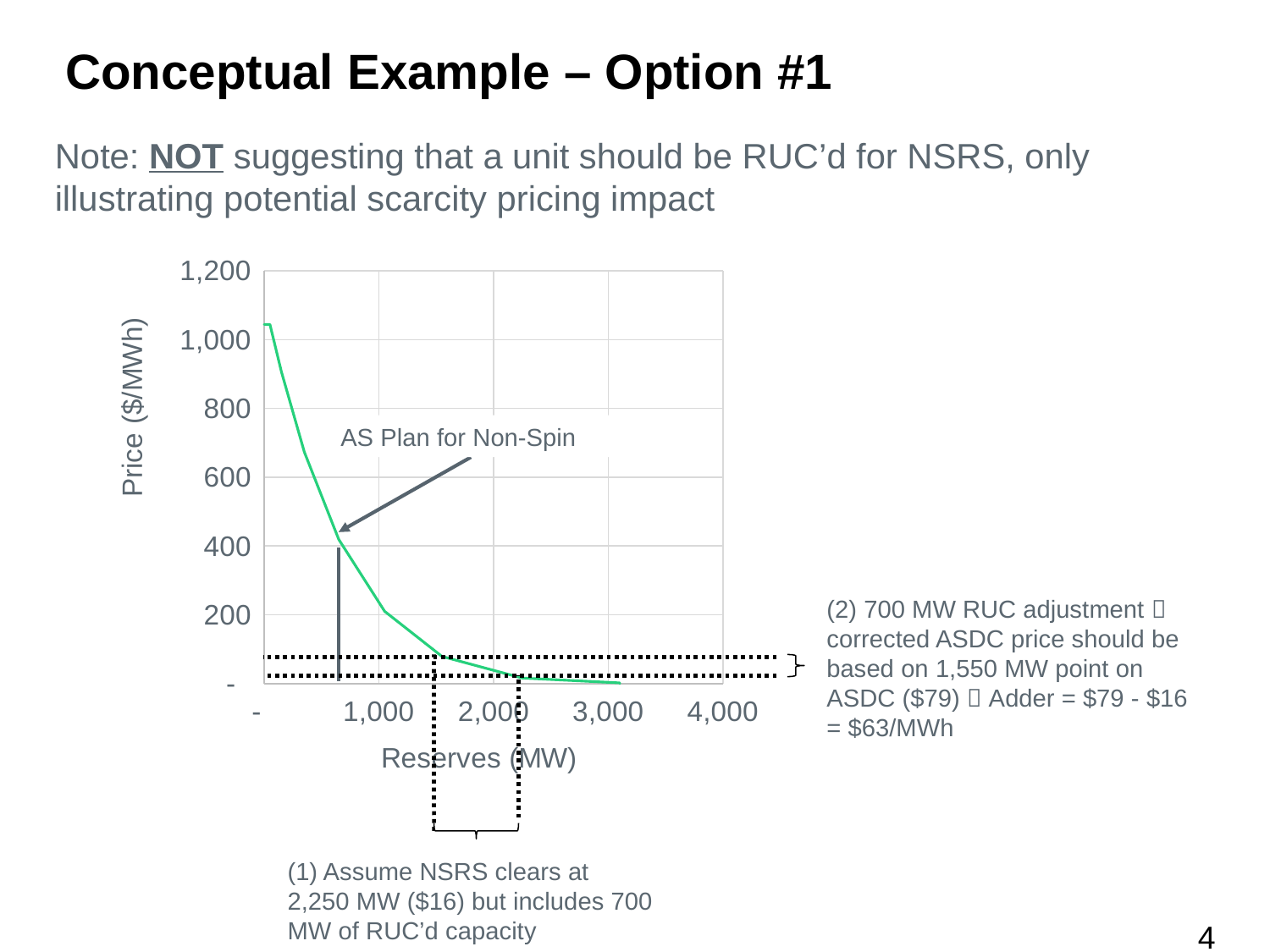
What is the highest value shown on the y axis of the chart? 1,200 Does the price rise or fall as reserves increase along the x axis? fall Is the price on the curve at 2,000 MW of reserves greater or less than 200? less According to the annotation, at what price does NSRS clear at 2,250 MW? $16 According to the annotation, what is the ASDC price at the 1,550 MW point? $79 What is the title of the y axis of the chart? Price ($/MWh) What is the title of the x axis of the chart? Reserves (MW) What is the difference between the ASDC price at 1,550 MW ($79) and the clearing price at 2,250 MW ($16)? $63/MWh How many MW of RUC'd capacity does the annotation say are included in the NSRS clearing? 700 MW What kind of chart is shown on the slide? line chart Which is larger: the price on the curve at 500 MW of reserves or at 1,500 MW of reserves? 500 MW